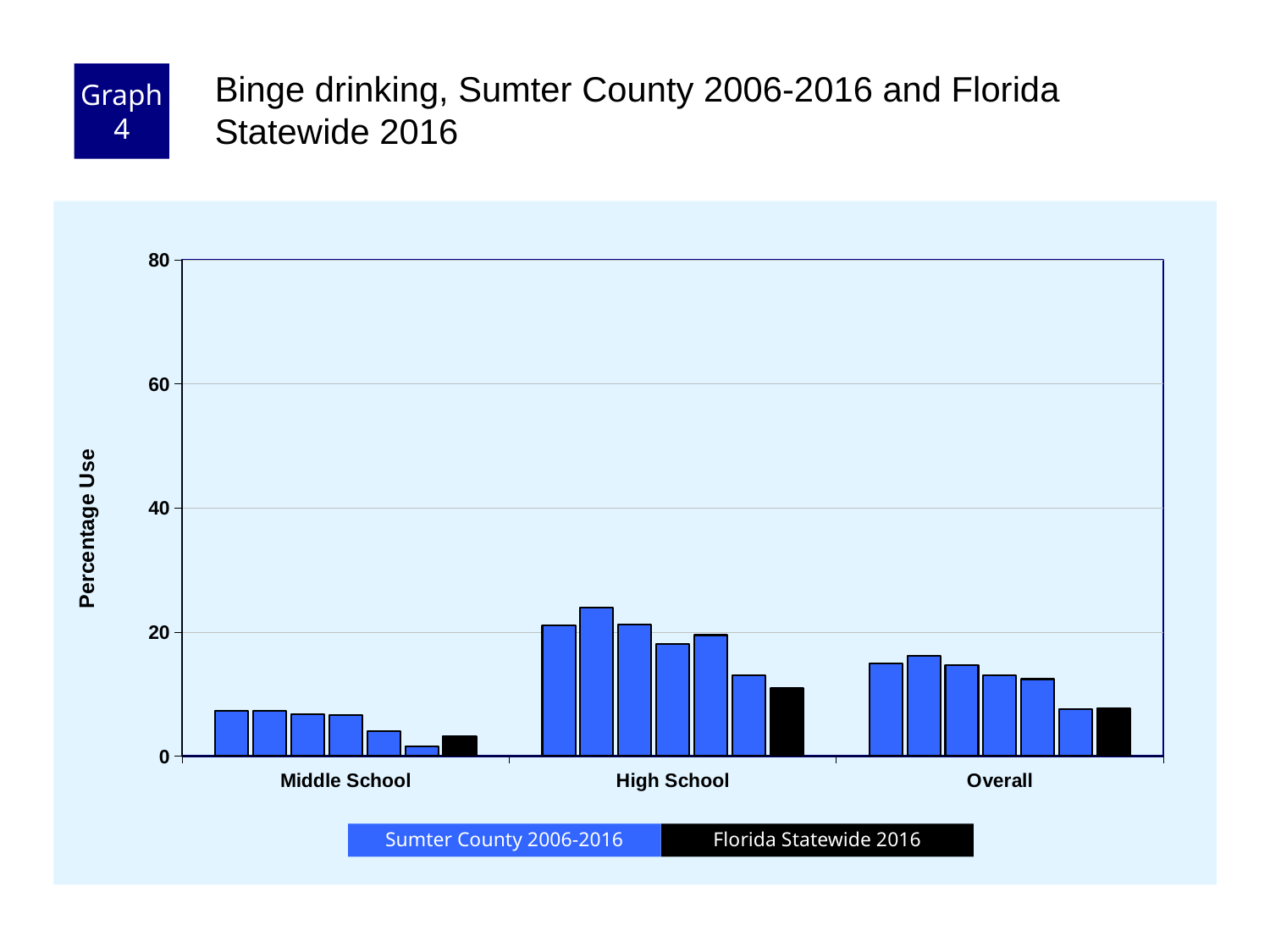
Is the Florida Statewide 2016 value for High School greater or less than 20? less Which category has the tallest bars overall? High School Which is larger, the Florida Statewide 2016 value for High School or for Middle School? High School Is the Florida Statewide 2016 value for Middle School greater or less than 20? less Is the tallest Sumter County 2006-2016 bar for High School greater or less than 20? greater How many categories are shown on the x axis of the chart? 3 What kind of chart is shown on the slide? bar chart Which series is shown in black in the legend? Florida Statewide 2016 Which category has the lowest Florida Statewide 2016 value? Middle School How many series does the chart's legend list? 2 What is the label of the y axis? Percentage Use